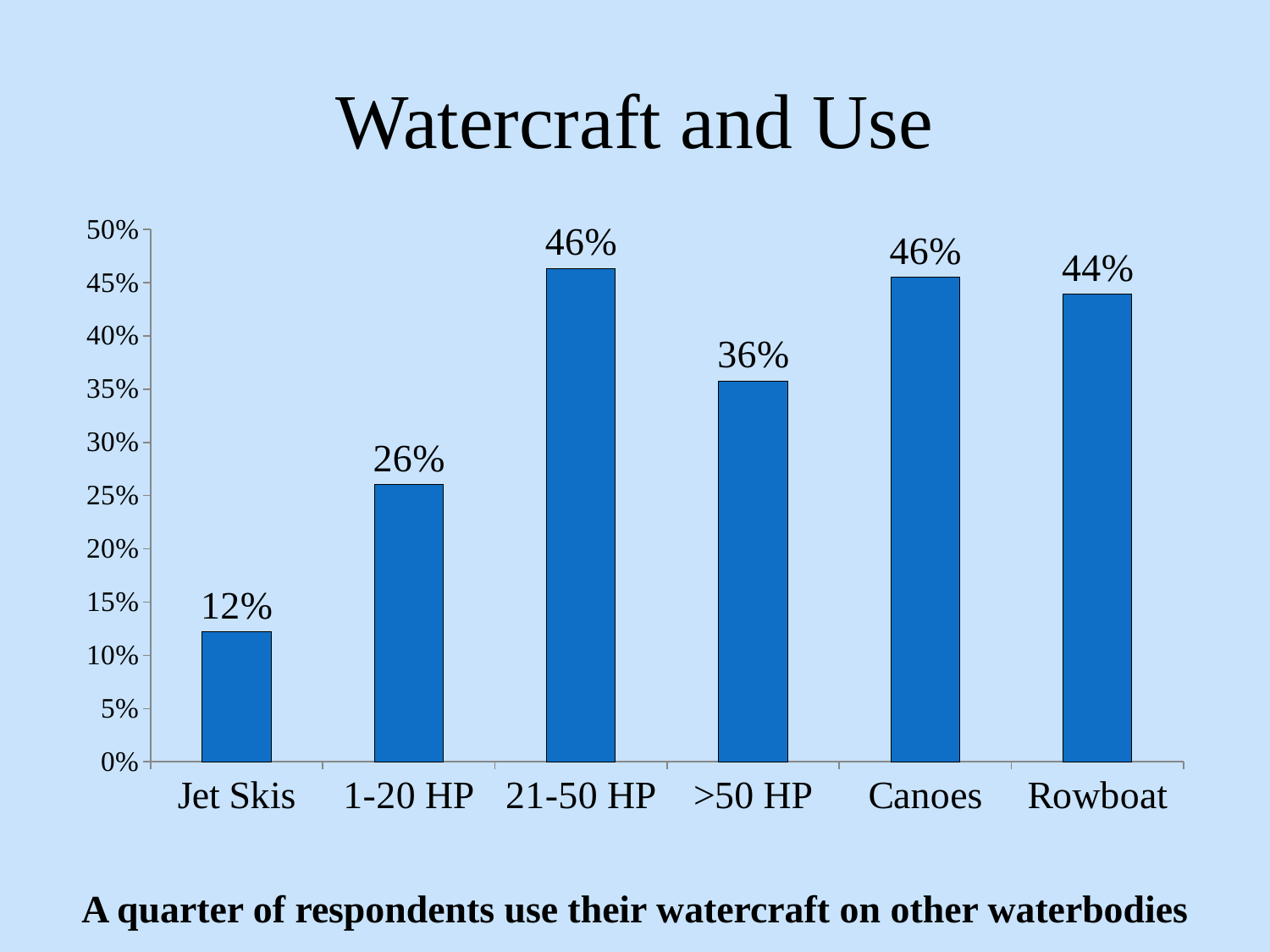
What is the difference between the values for 21-50 HP and >50 HP? 10% What is the value for Jet Skis? 12% Which is larger, the value for Canoes or the value for >50 HP? Canoes What is the title of the chart? Watercraft and Use Is the value for Rowboat greater or less than 40%? greater What is the value for >50 HP? 36% What is the value for 1-20 HP? 26% What kind of chart is shown on the slide? bar chart What is the difference between the values for 1-20 HP and Jet Skis? 14% Which category has the lowest value? Jet Skis What is the value for Rowboat? 44% How many categories are shown on the x axis? 6